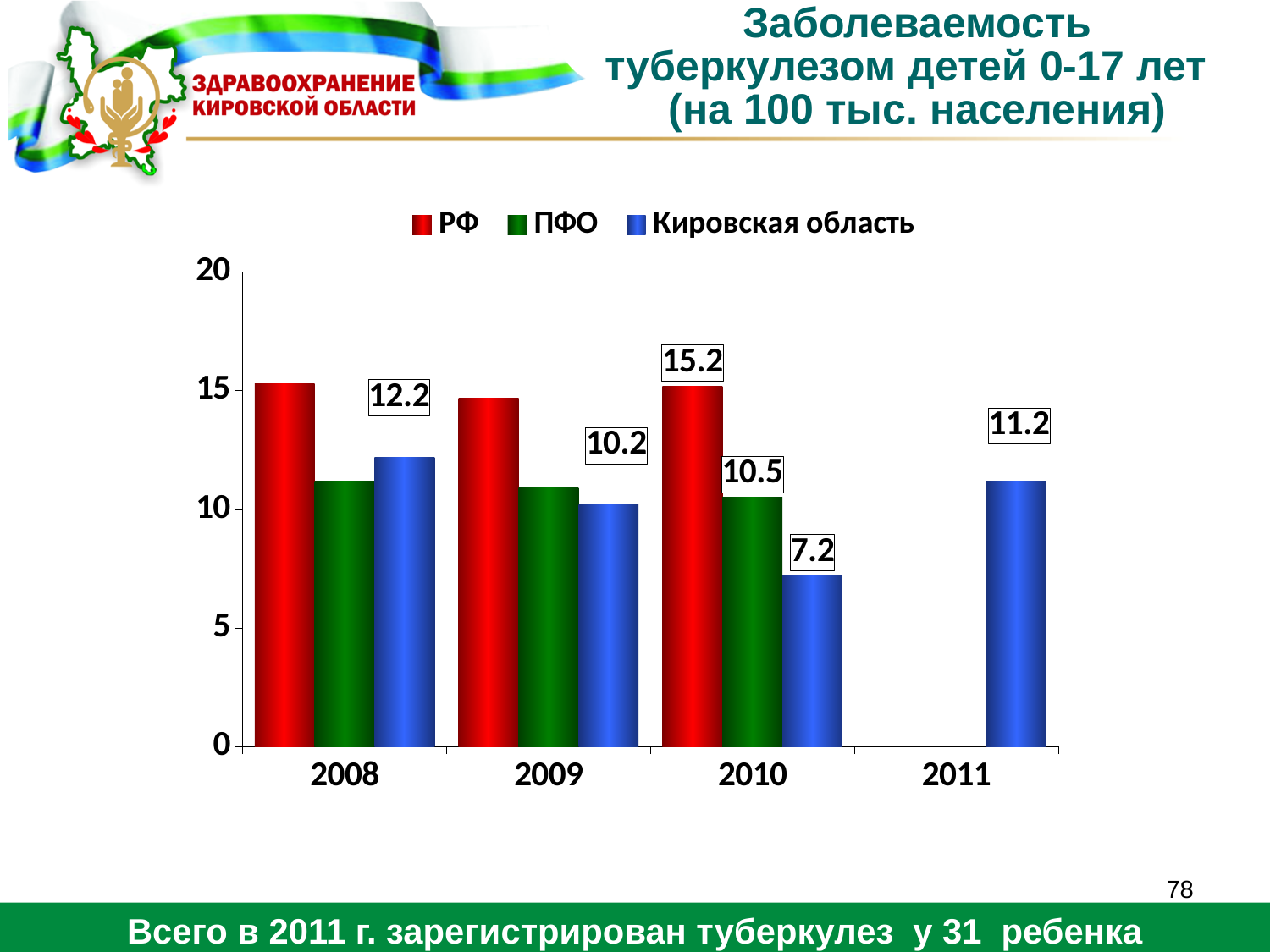
Is the value for ПФО in 2008 greater or less than 15? less What is the value for Кировская область in 2011? 11.2 Which is larger in 2010, the value for ПФО or the value for Кировская область? ПФО What is the value for Кировская область in 2010? 7.2 In which year is the value for Кировская область the lowest? 2010 How many series does the legend list? 3 What kind of chart is shown on the slide? bar chart What is the value for РФ in 2010? 15.2 In which year is the value for Кировская область the highest? 2008 What is the difference between the РФ value and the Кировская область value in 2010? 8.0 Does the value for Кировская область rise or fall from 2008 to 2010? fall What is the value for ПФО in 2010? 10.5